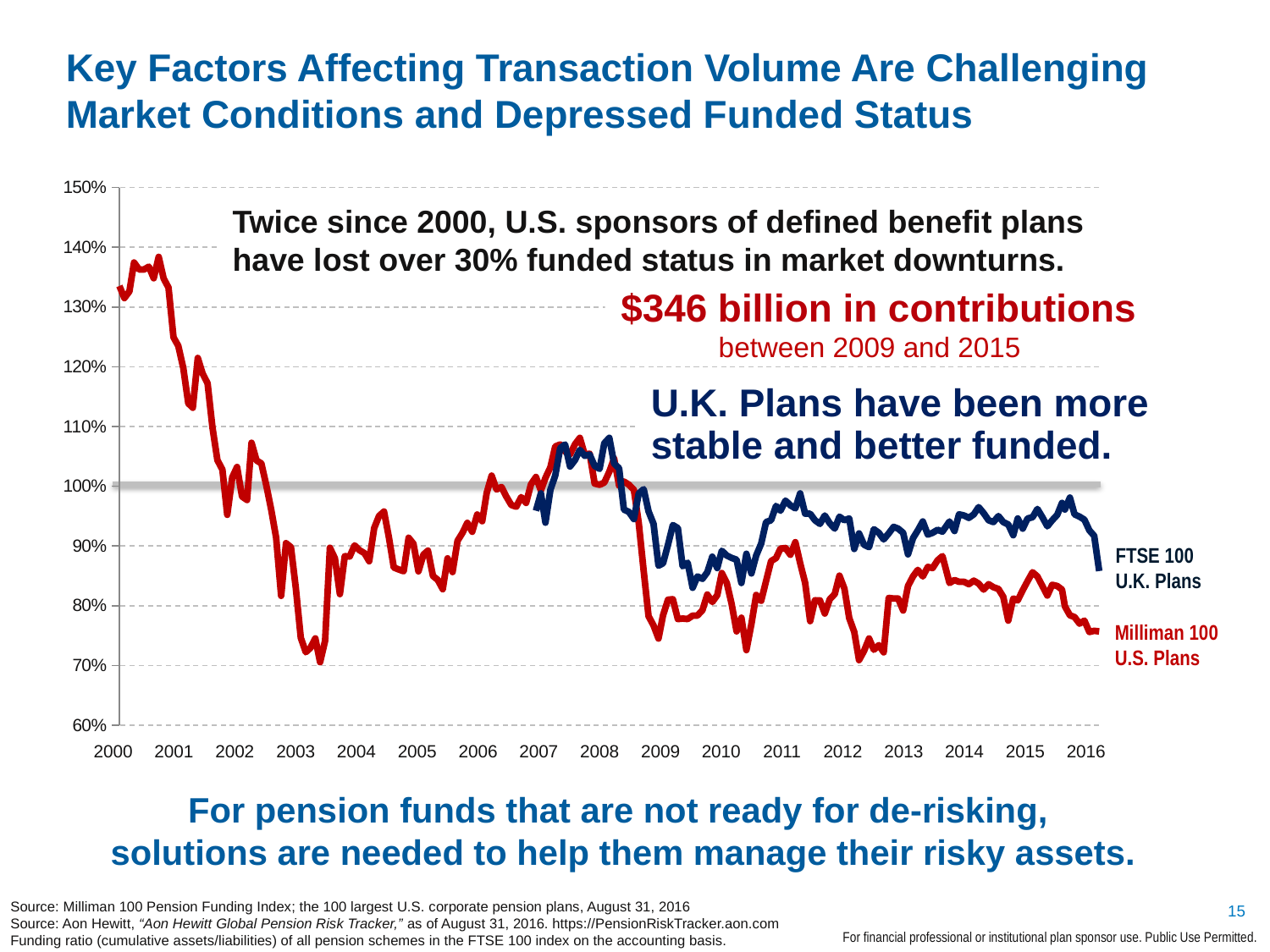
Which series reaches the highest value shown anywhere on the chart? Milliman 100 U.S. Plans How many data series are plotted on the chart? 2 How many year labels appear on the x axis of the chart? 17 Is the value for Milliman 100 U.S. Plans at the start of 2000 greater or less than 120%? greater Is the value for Milliman 100 U.S. Plans at the end of the series in 2016 greater or less than 80%? less In 2012, which series has the higher funded status, FTSE 100 U.K. Plans or Milliman 100 U.S. Plans? FTSE 100 U.K. Plans What is the highest value shown on the y axis of the chart? 150% Does the Milliman 100 U.S. Plans line rise or fall between 2000 and 2003? fall Which series is drawn in red on the chart? Milliman 100 U.S. Plans Is the value for FTSE 100 U.K. Plans at the end of the series in 2016 greater or less than 80%? greater What type of chart is shown on the slide? line chart